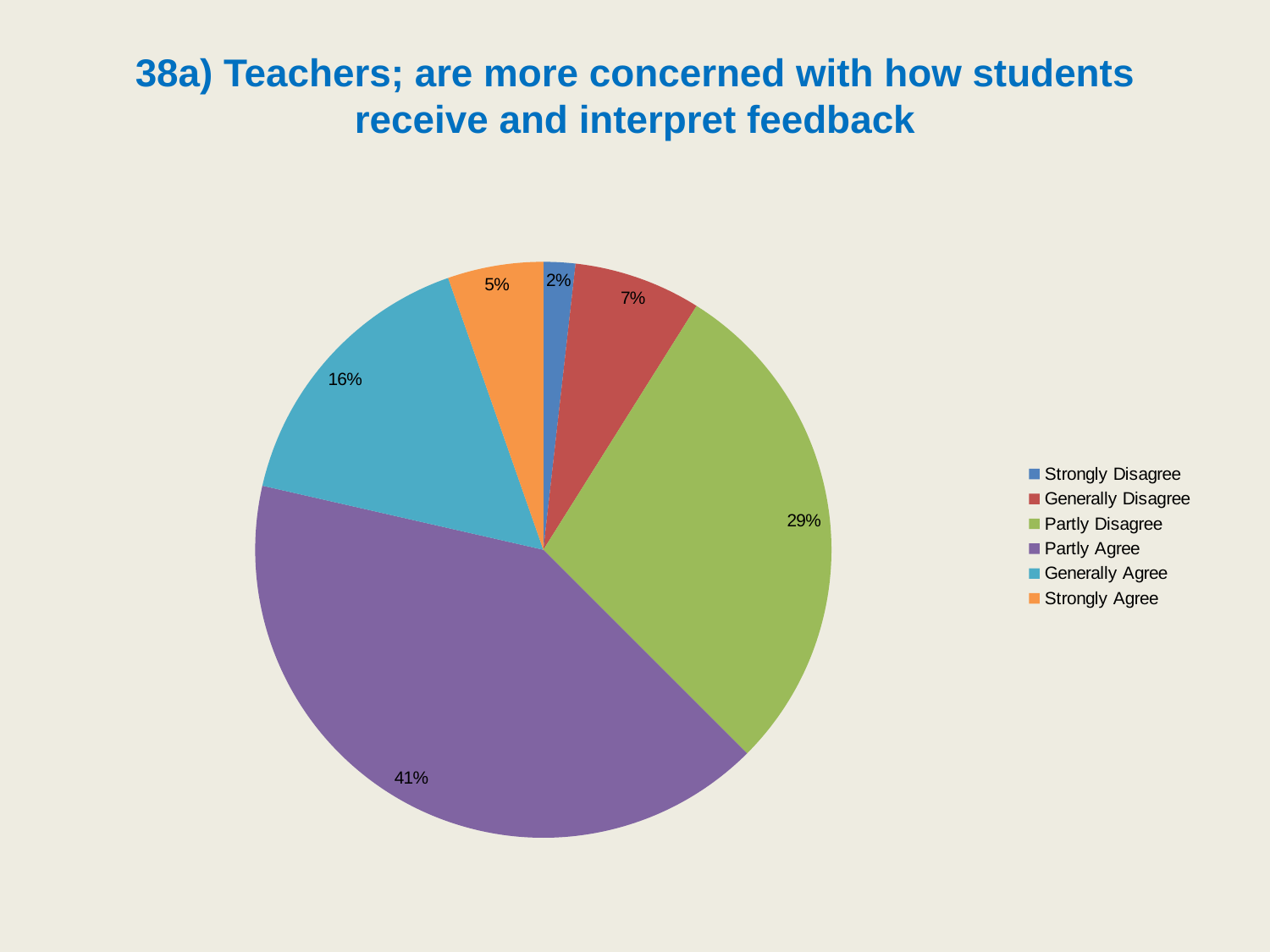
What kind of chart is shown on the slide? pie chart What is the difference in percentage points between Partly Agree and Partly Disagree? 12 What percentage of respondents chose Partly Disagree? 29% What percentage of respondents chose Partly Agree? 41% Which response category has the largest share of the pie? Partly Agree What percentage of respondents chose Strongly Disagree? 2% What percentage of respondents chose Strongly Agree? 5% How many categories does the legend list? 6 Which is larger, the share for Generally Disagree or the share for Generally Agree? Generally Agree Which response category has the smallest share of the pie? Strongly Disagree What colour is the Partly Agree slice? purple What percentage of respondents chose Generally Agree? 16%